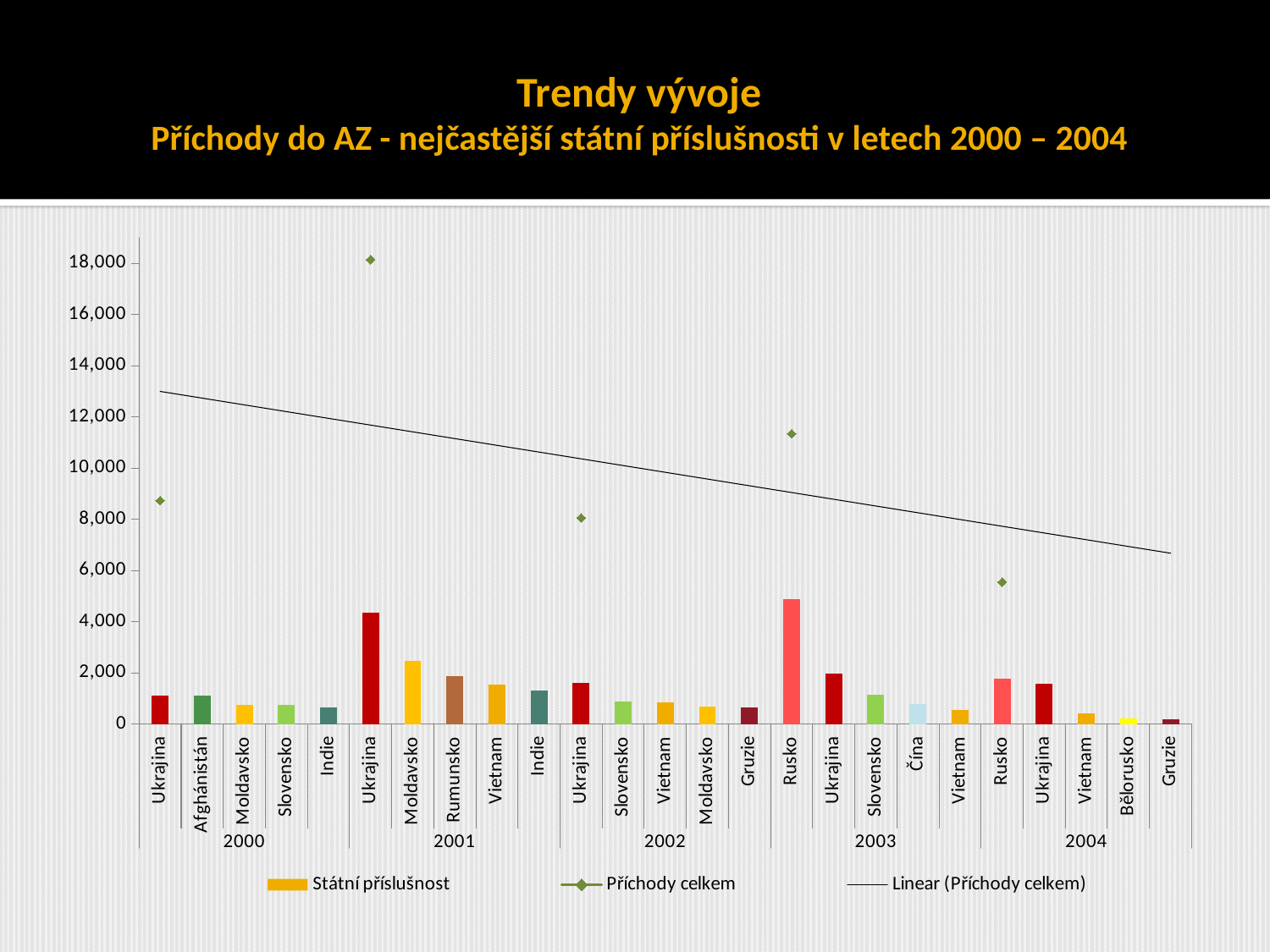
In which year is the Příchody celkem marker the lowest? 2004 Is the bar for Moldavsko in 2001 greater or less than 2,000? greater Is the Příchody celkem value for 2004 greater or less than 6,000? less Does the Linear (Příchody celkem) trend line rise or fall from 2000 to 2004? fall How many series does the legend list? 3 What kind of chart is shown on the slide? combination bar and line chart Which is larger in 2003: the bar for Rusko or the bar for Ukrajina? Rusko How many year groups are shown along the x axis? 5 How many bars (Státní příslušnost) are plotted in total across all years? 25 Is the Příchody celkem value for 2001 greater or less than 16,000? greater In which year is the Příchody celkem marker the highest? 2001 Which bar is the highest in the chart? Rusko (2003)